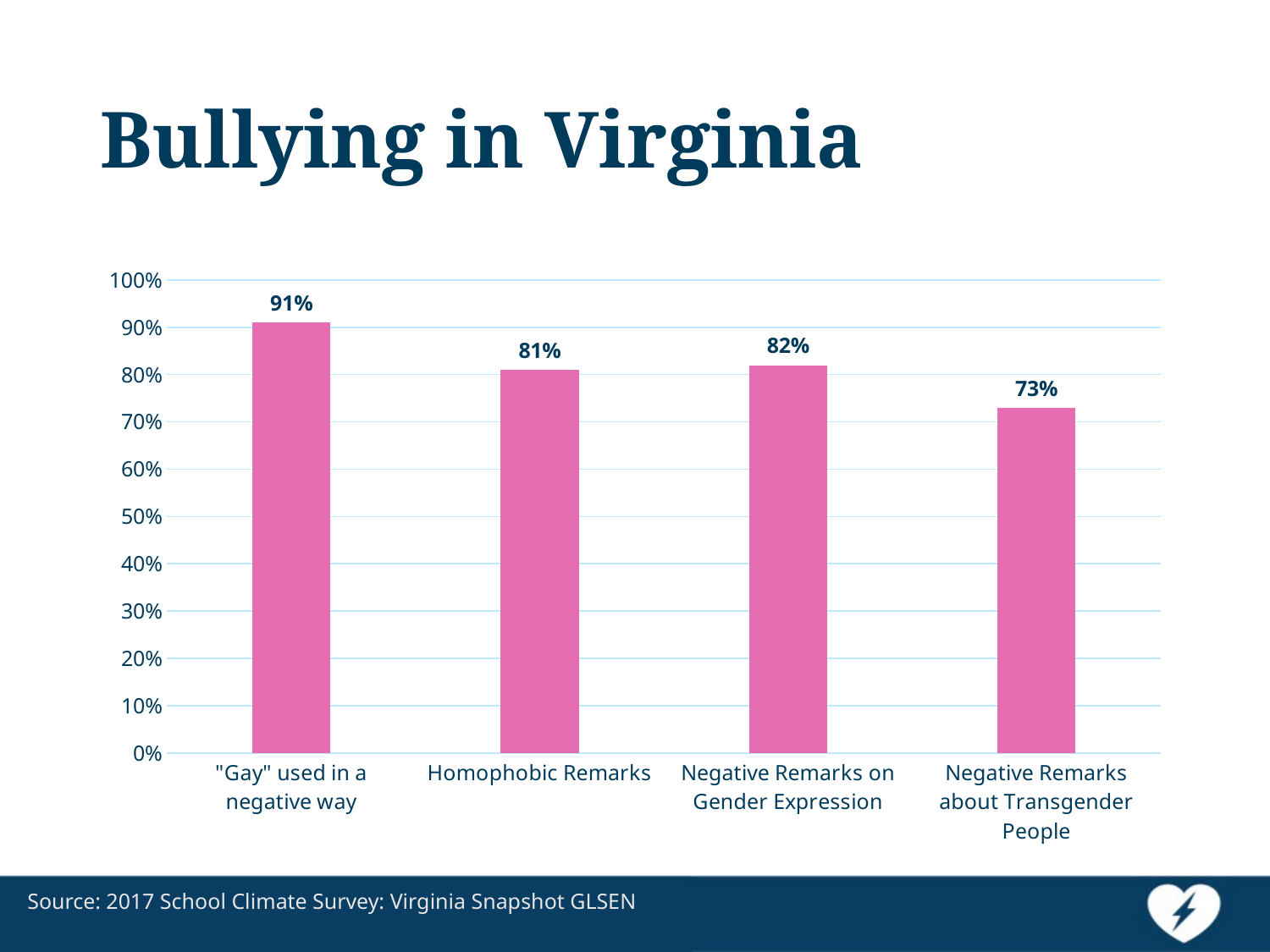
What kind of chart is shown on the slide? Bar chart What is the difference between the values for Negative Remarks on Gender Expression and Homophobic Remarks? 1% What is the value for Negative Remarks on Gender Expression? 82% What is the value for Negative Remarks about Transgender People? 73% Which category has the highest value? "Gay" used in a negative way Which is larger, the value for Homophobic Remarks or the value for Negative Remarks about Transgender People? Homophobic Remarks How many categories are shown in the chart? 4 Which category has the lowest value? Negative Remarks about Transgender People What is the title of the slide containing the chart? Bullying in Virginia What is the value for Homophobic Remarks? 81% What is the value for "Gay" used in a negative way? 91% What is the difference between the values for "Gay" used in a negative way and Negative Remarks about Transgender People? 18%